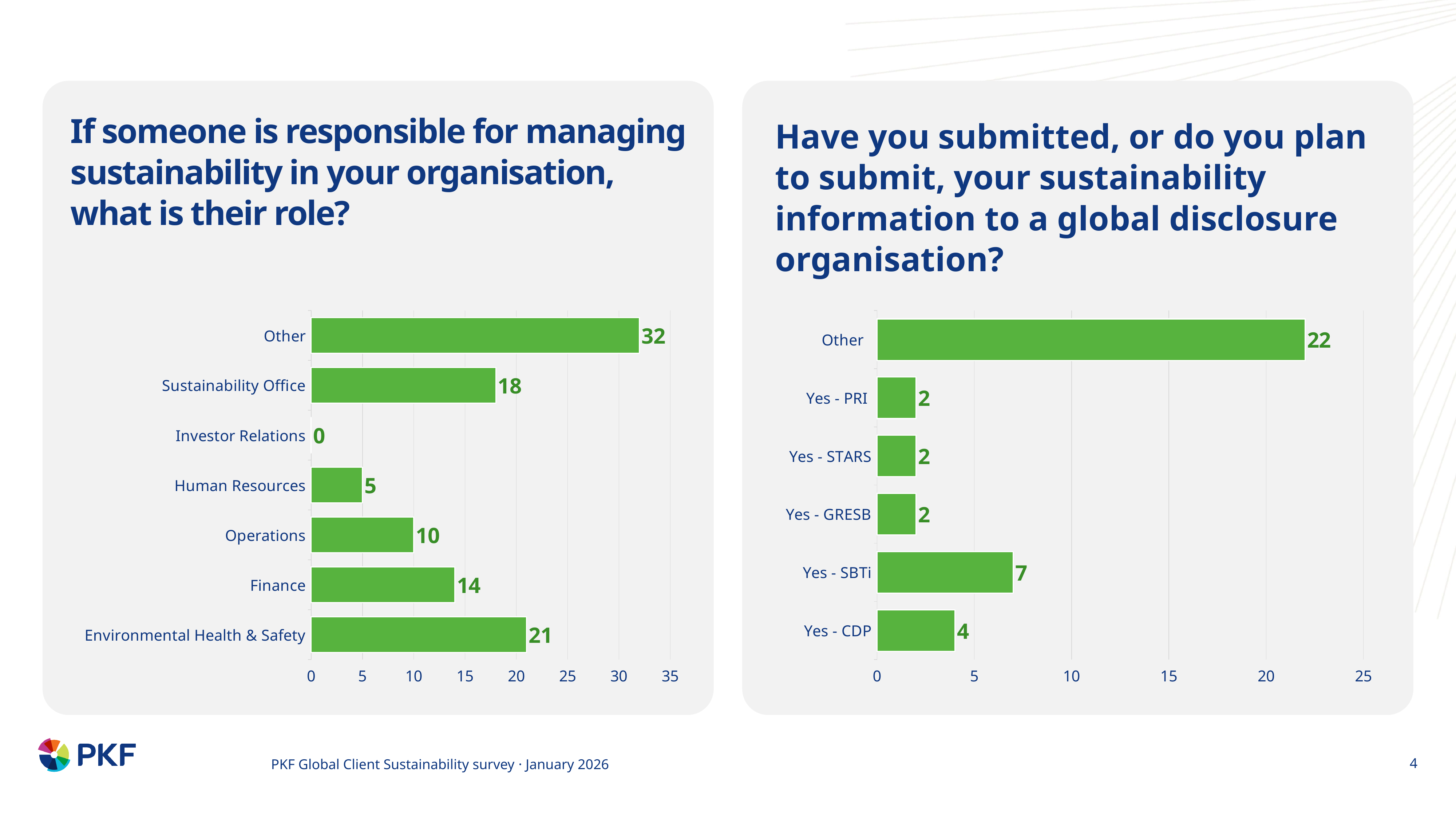
In the left chart about who manages sustainability, what is the value for Sustainability Office? 18 In the right chart about submitting to a global disclosure organisation, what is the value for Yes - SBTi? 7 In the right chart about submitting to a global disclosure organisation, what is the value for Yes - CDP? 4 What type of chart is the right chart about submitting to a global disclosure organisation? Bar chart In the right chart about submitting to a global disclosure organisation, what is the difference between Other and Yes - SBTi? 15 In the left chart about who manages sustainability, which category has the highest value? Other In the left chart about who manages sustainability, what is the value for Environmental Health & Safety? 21 In the right chart about submitting to a global disclosure organisation, which category has the highest value? Other In the left chart about who manages sustainability, which category has the lowest value? Investor Relations In the left chart about who manages sustainability, how many categories are shown? 7 In the left chart about who manages sustainability, what is the difference between Finance and Operations? 4 In the right chart about submitting to a global disclosure organisation, which is larger, Yes - SBTi or Yes - CDP? Yes - SBTi